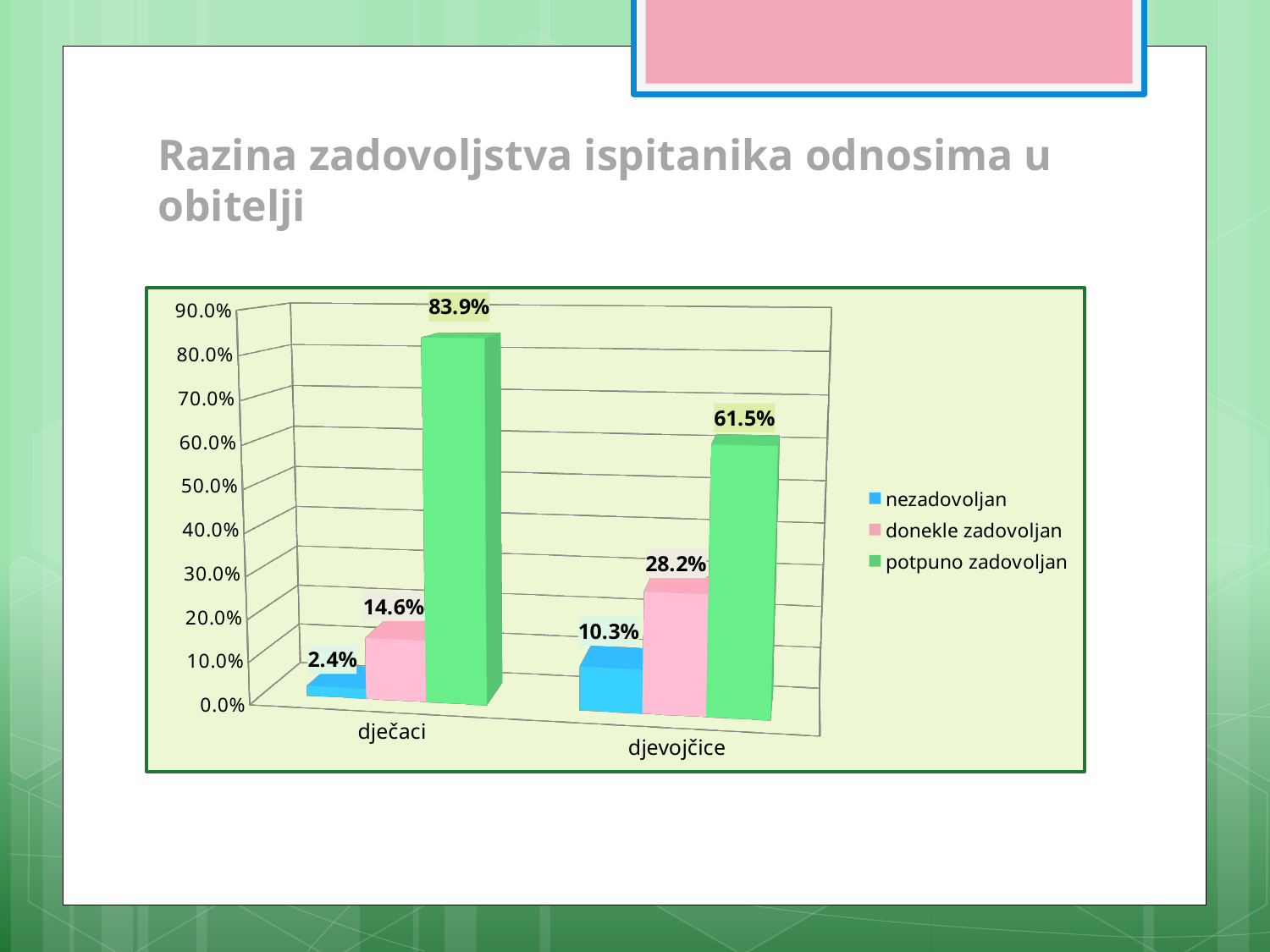
What is the value for 'donekle zadovoljan' for djevojčice? 28.2% Which category has the highest value for 'potpuno zadovoljan'? dječaci What is the title of the slide above the chart? Razina zadovoljstva ispitanika odnosima u obitelji What is the difference between the 'potpuno zadovoljan' values for dječaci and djevojčice? 22.4% What is the value for 'nezadovoljan' for djevojčice? 10.3% What kind of chart is shown on the slide? bar chart How many categories are shown on the x axis? 2 What is the value for 'potpuno zadovoljan' for dječaci? 83.9% What is the value for 'donekle zadovoljan' for dječaci? 14.6% Which is larger: 'donekle zadovoljan' for dječaci or for djevojčice? djevojčice How many series does the legend list? 3 Which category has the lowest value for 'nezadovoljan'? dječaci